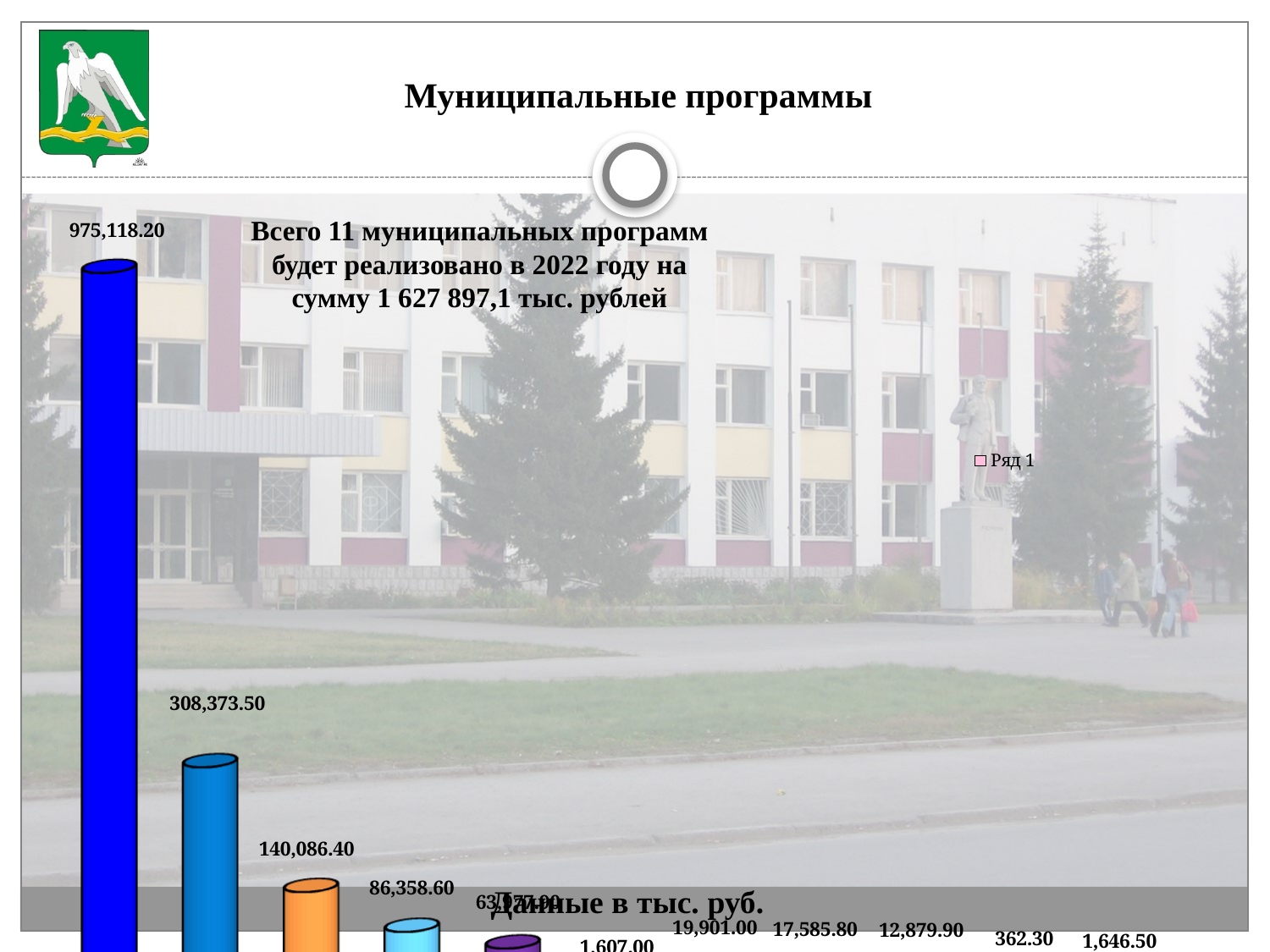
How many series does the chart legend list? 1 How many data labels (bars) are shown in the chart? 11 What is the name of the series shown in the chart legend? Ряд 1 Which is larger, the second bar from the left or the third bar from the left? the second bar (308,373.50) What is the smallest value labelled in the chart? 362.30 What is the value labelled on the second bar from the left? 308,373.50 What is the title of the slide containing the chart? Муниципальные программы What kind of chart is shown on the slide? bar chart What is the value labelled on the third bar from the left? 140,086.40 What is the difference between the first bar (975,118.20) and the second bar (308,373.50)? 666,744.70 What is the value labelled on the fourth bar from the left? 86,358.60 What is the value of the tallest (leftmost) bar in the chart? 975,118.20